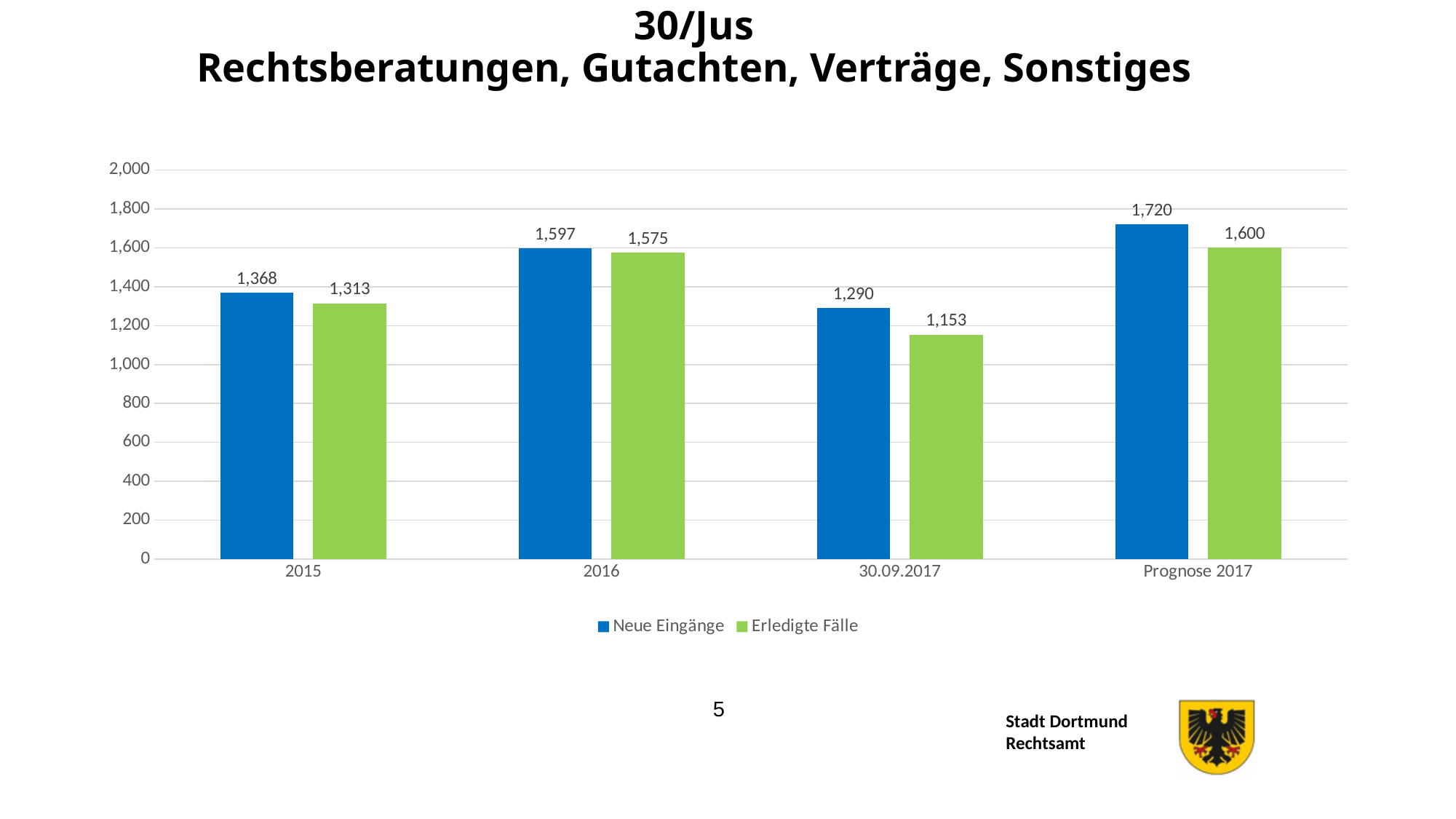
What is the difference between Neue Eingänge in 2016 and in 2015? 229 What is the value of Neue Eingänge for 2015? 1,368 What is the difference between Neue Eingänge and Erledigte Fälle for 30.09.2017? 137 How many series does the legend list? 2 Which is larger for 2016: Neue Eingänge or Erledigte Fälle? Neue Eingänge What kind of chart is shown on the slide? Bar chart Which category has the highest value for Neue Eingänge? Prognose 2017 What is the value of Erledigte Fälle for 30.09.2017? 1,153 Which category has the lowest value for Erledigte Fälle? 30.09.2017 What is the value of Erledigte Fälle for Prognose 2017? 1,600 Which colour represents Erledigte Fälle in the chart? Green How many categories are shown on the x axis? 4